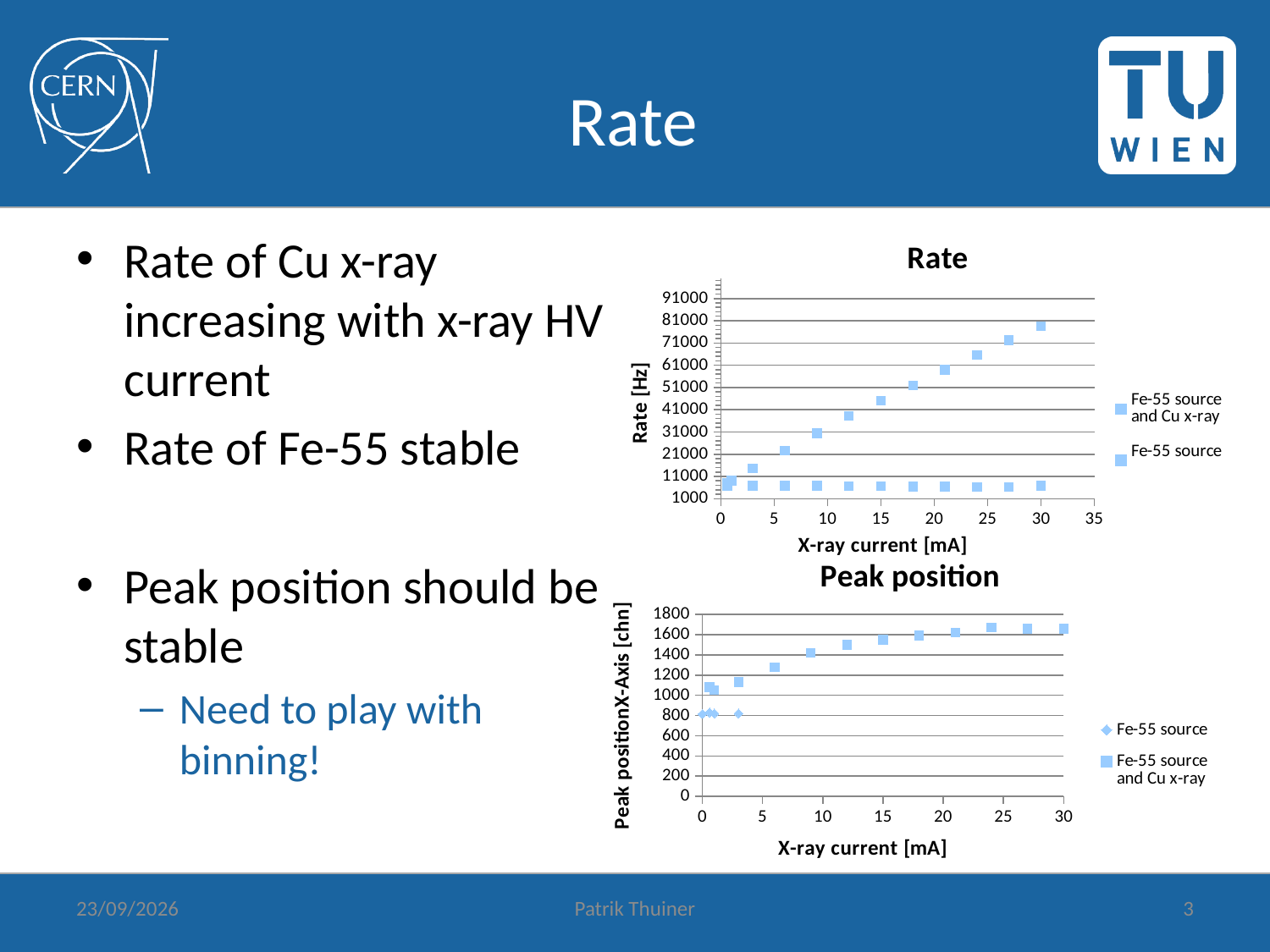
In the "Rate" chart, does the rate for the "Fe-55 source and Cu x-ray" series rise or fall as the x-ray current increases? rise In the "Peak position" chart, does the peak position for the "Fe-55 source and Cu x-ray" series rise or fall as the x-ray current increases? rise How many series does the legend of the "Peak position" chart list? 2 How many series does the legend of the "Rate" chart list? 2 In the "Rate" chart, what are the two series named in the legend? Fe-55 source and Cu x-ray; Fe-55 source In the "Rate" chart, at 30 mA, which series has the higher rate? Fe-55 source and Cu x-ray In the "Rate" chart, is the value of the "Fe-55 source" series at 30 mA greater or less than 11000? less What kind of chart is the "Rate" chart on the slide? scatter chart In the "Rate" chart, is the value of the "Fe-55 source and Cu x-ray" series at 21 mA greater or less than 51000? greater In the "Rate" chart, is the value of the "Fe-55 source and Cu x-ray" series at 30 mA greater or less than 71000? greater What is the x-axis title of the "Peak position" chart? X-ray current [mA]